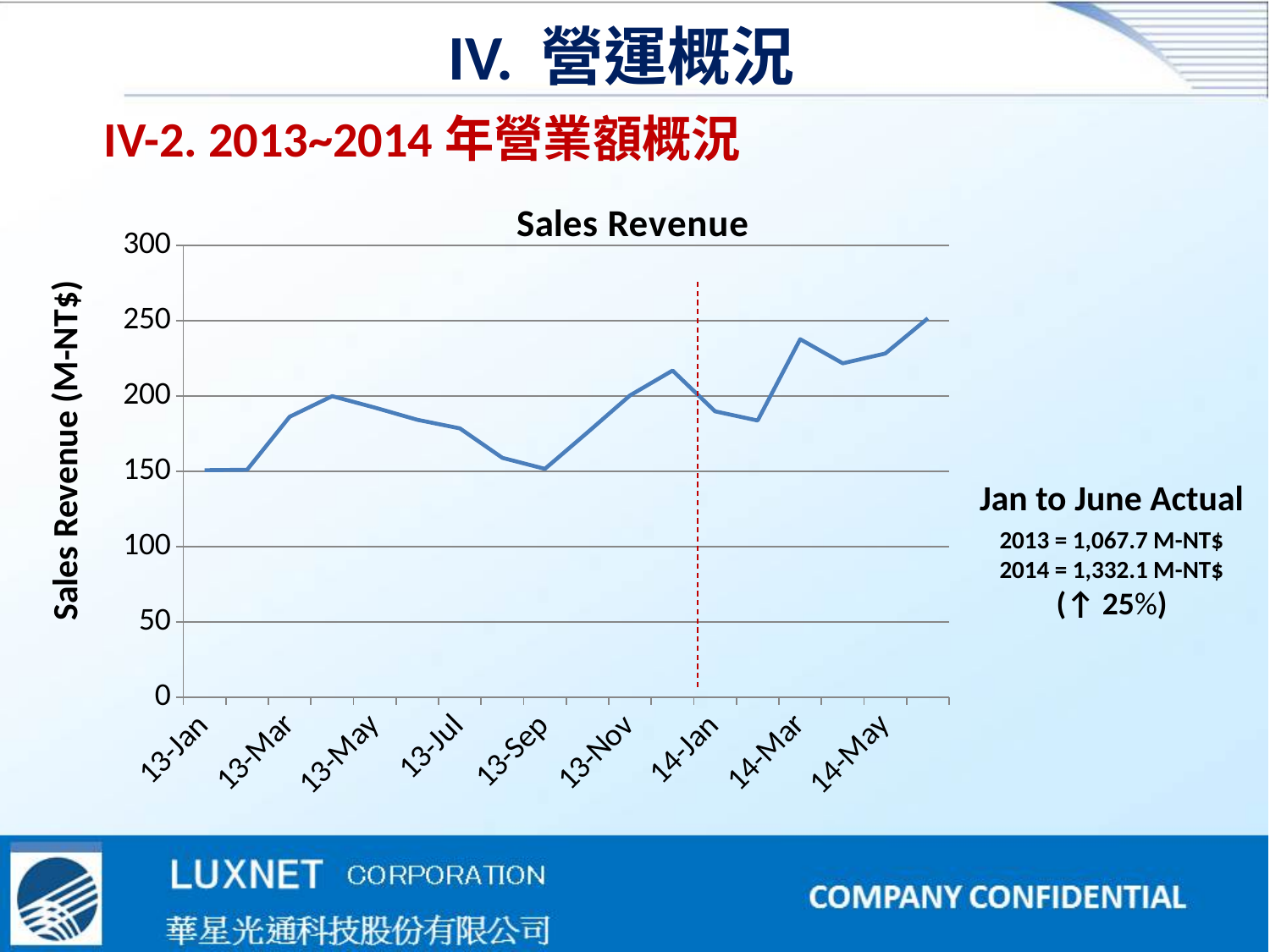
How many monthly data points are plotted on the line? 18 Is the sales revenue for 13-Jan greater or less than 200? less Is the sales revenue for 13-Dec greater or less than 200? greater Is the sales revenue for 14-Mar greater or less than 200? greater Does the sales revenue rise or fall from 13-Sep to 13-Dec? rise Which month has the highest sales revenue on the chart? 14-Jun According to the note beside the chart, what was the Jan to June actual sales revenue for 2014? 1,332.1 M-NT$ What is the label on the vertical axis of the chart? Sales Revenue (M-NT$) What kind of chart is shown on the slide? line chart What is the title of the chart? Sales Revenue Which month has higher sales revenue, 13-Dec or 14-Jan? 13-Dec